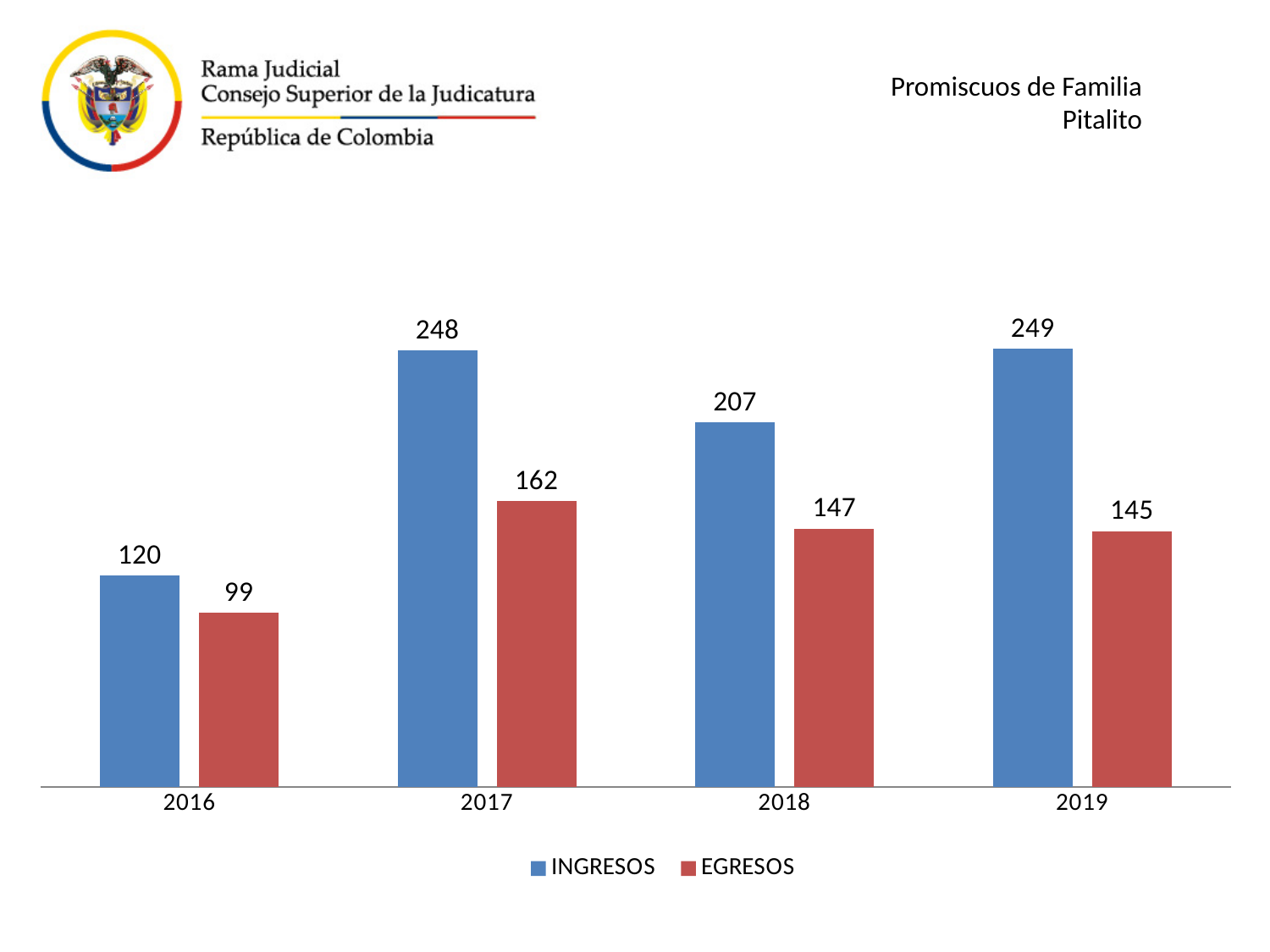
Which year has the highest INGRESOS value? 2019 How many years are shown on the x axis? 4 Which is larger, INGRESOS in 2018 or EGRESOS in 2017? INGRESOS in 2018 What is the difference between INGRESOS and EGRESOS in 2017? 86 What kind of chart is shown on the slide? Bar chart Which year has the lowest EGRESOS value? 2016 Which colour represents EGRESOS in the chart? Red What is the difference between INGRESOS in 2019 and INGRESOS in 2016? 129 What is the EGRESOS value for 2016? 99 What is the EGRESOS value for 2018? 147 What is the INGRESOS value for 2017? 248 How many series does the legend list? 2